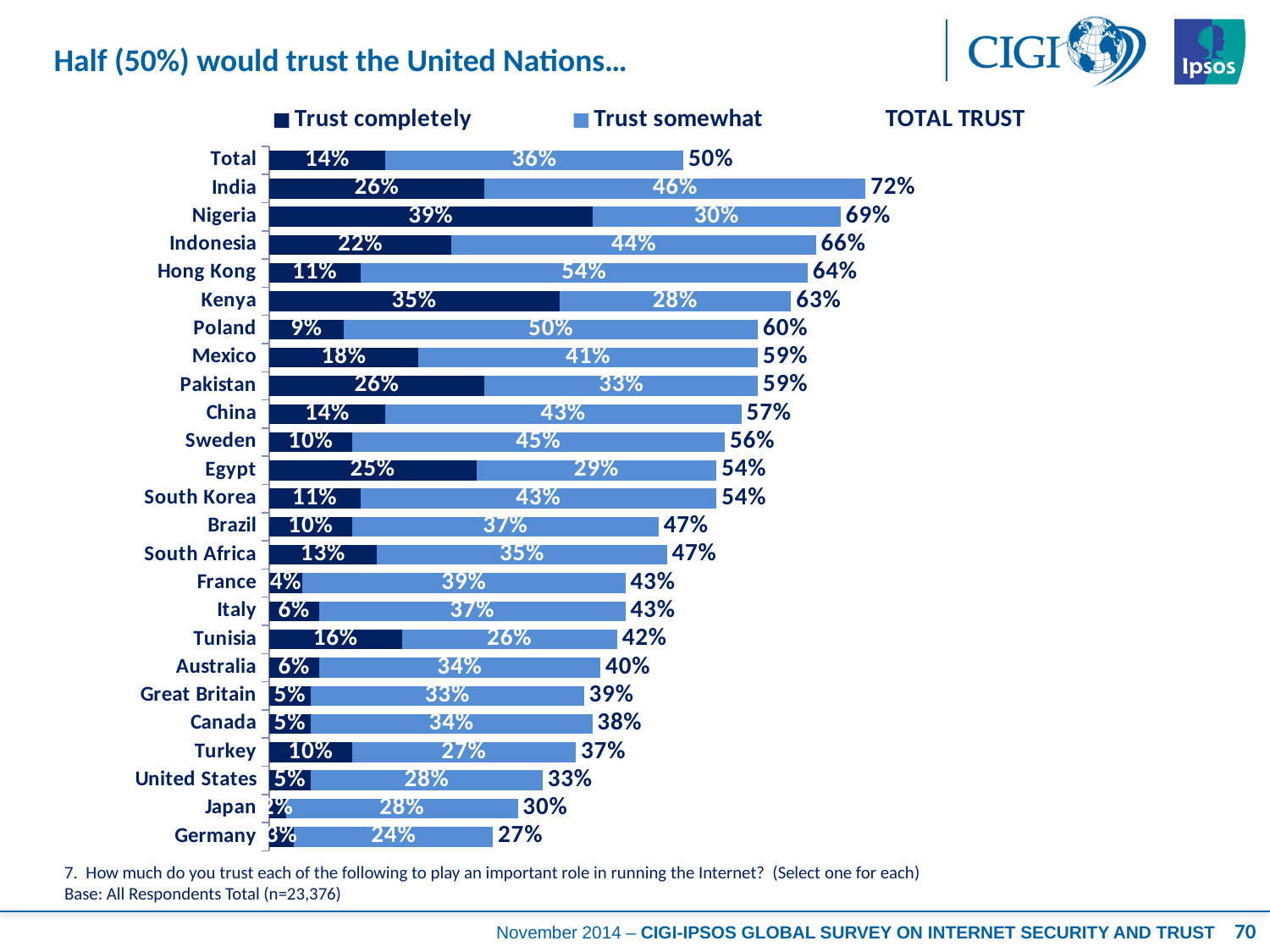
Which country has the highest 'Trust completely' value? Nigeria What is the total trust value shown for India? 72% Which country has the highest total trust value? India What is the 'Trust completely' value for Nigeria? 39% What kind of chart is shown on the slide? Stacked bar chart What is the total of the stacked bar for Mexico? 59% What is the difference between the total trust values for India and Germany? 45% How many categories are plotted on the chart? 25 Which is larger, the 'Trust somewhat' value for Poland or for Kenya? Poland Which country has the lowest total trust value? Germany What is the 'Trust somewhat' value for Hong Kong? 54%